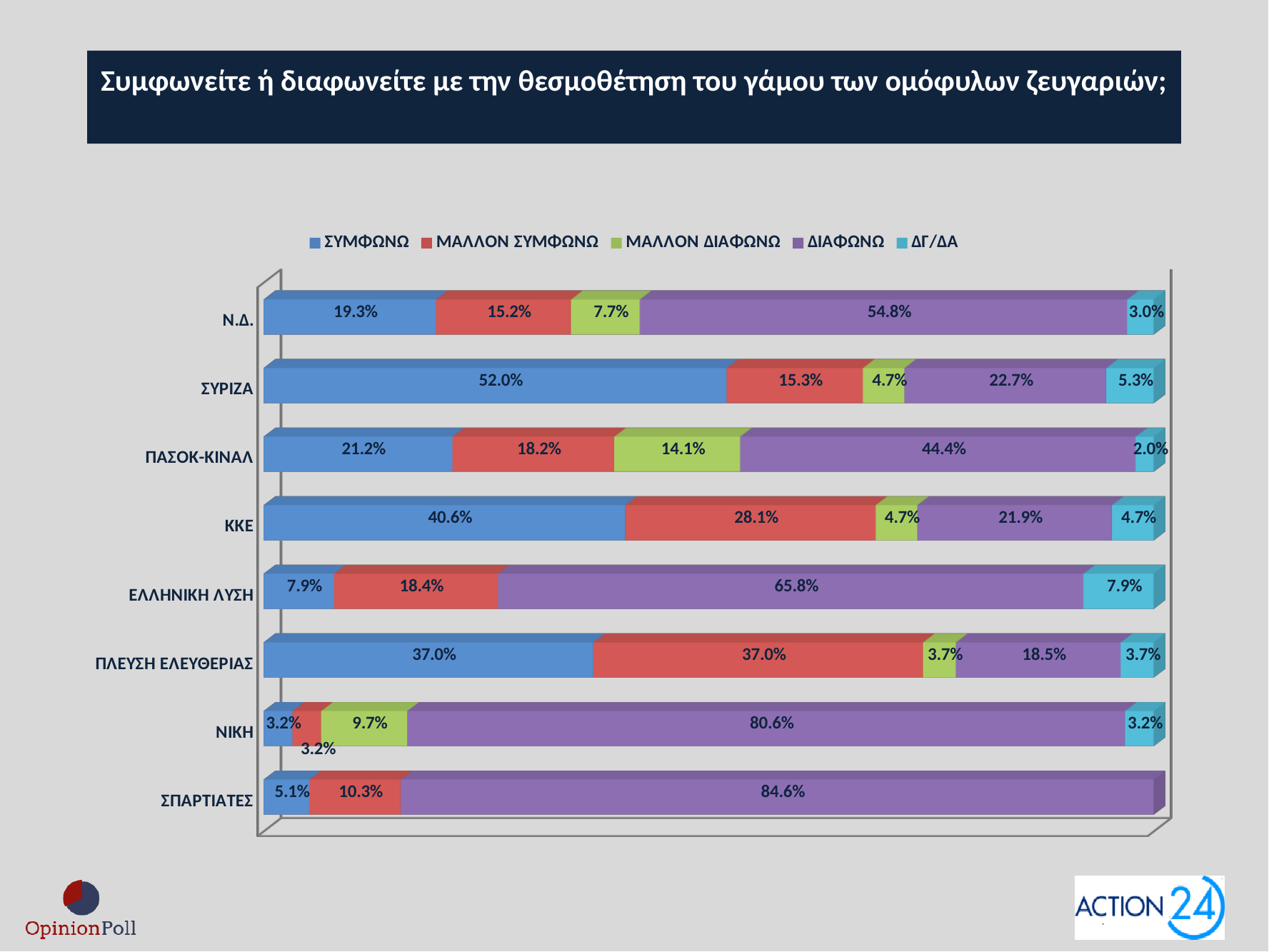
What is the difference between the ΣΥΜΦΩΝΩ values for ΣΥΡΙΖΑ and ΚΚΕ? 11.4 percentage points How many parties are shown on the chart? 8 What kind of chart is shown on the slide? Stacked bar chart What is the ΔΓ/ΔΑ value for ΕΛΛΗΝΙΚΗ ΛΥΣΗ? 7.9% What percentage of Ν.Δ. respondents answered ΔΙΑΦΩΝΩ? 54.8% Which is larger: the ΜΑΛΛΟΝ ΣΥΜΦΩΝΩ value for ΚΚΕ or for ΠΑΣΟΚ-ΚΙΝΑΛ? ΚΚΕ Which party has the lowest ΣΥΜΦΩΝΩ value? ΝΙΚΗ How many series does the legend list? 5 What is the ΣΥΜΦΩΝΩ value for ΣΥΡΙΖΑ? 52.0% What is the total of the stacked bar for ΣΠΑΡΤΙΑΤΕΣ? 100.0% Which party has the highest ΔΙΑΦΩΝΩ value? ΣΠΑΡΤΙΑΤΕΣ What is the ΜΑΛΛΟΝ ΔΙΑΦΩΝΩ value for ΠΑΣΟΚ-ΚΙΝΑΛ? 14.1%